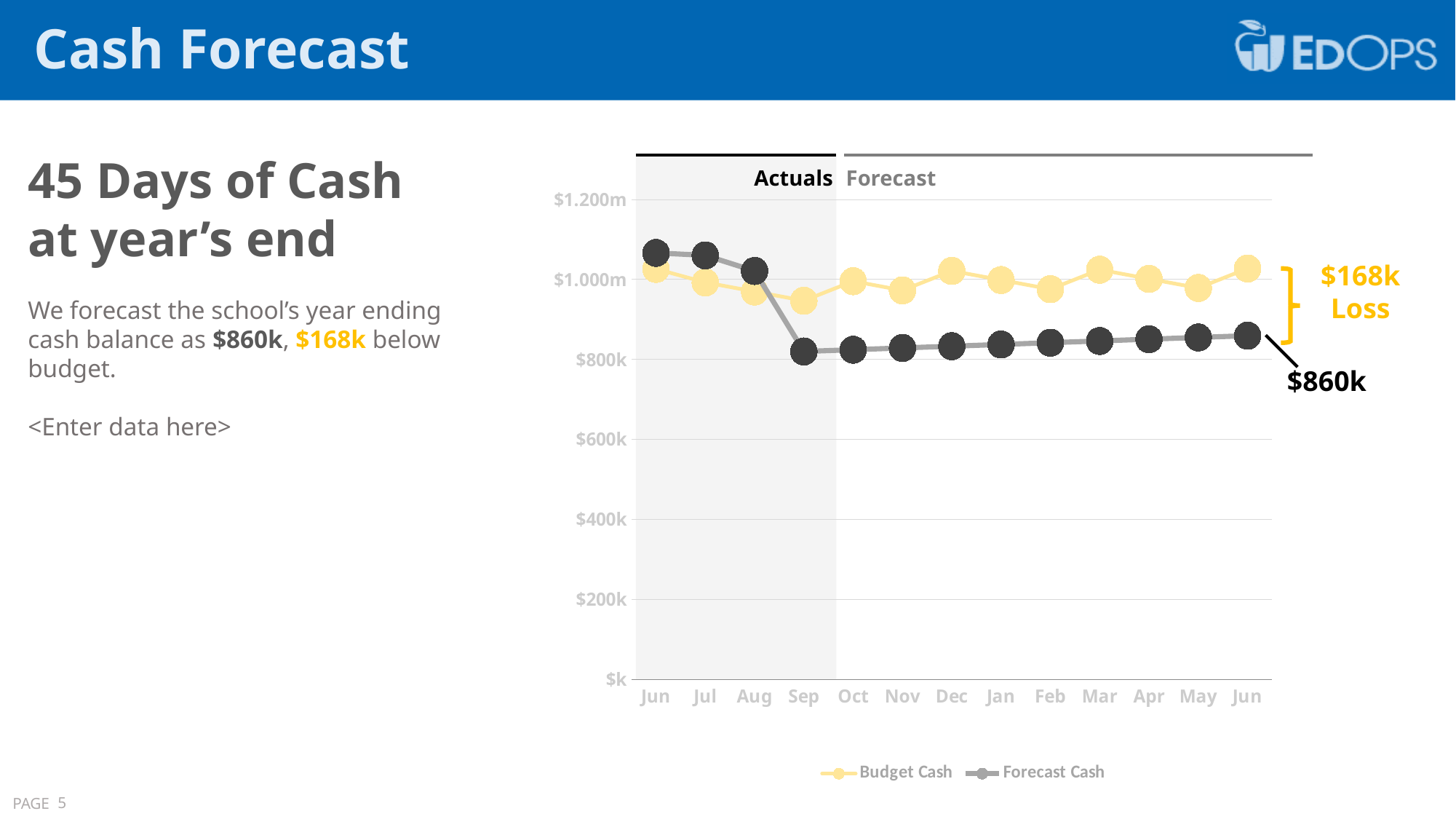
By how much is the year-end Forecast Cash below Budget Cash, according to the chart annotation? $168k How many months are plotted along the x axis of the chart? 13 Is the Forecast Cash value for Mar greater or less than $800k? greater Is the Forecast Cash value for Sep greater or less than $1.000m? less What type of chart is shown on the slide? line chart In Dec, which series has the higher value, Budget Cash or Forecast Cash? Budget Cash What is the Forecast Cash value at the final Jun point on the chart? $860k Which series is drawn in yellow on the chart? Budget Cash How many series does the chart legend list? 2 Does the Forecast Cash line rise or fall from Jun to Sep? fall Is the Forecast Cash value for the first Jun greater or less than $1.000m? greater What label is given to the shaded region on the left of the chart? Actuals